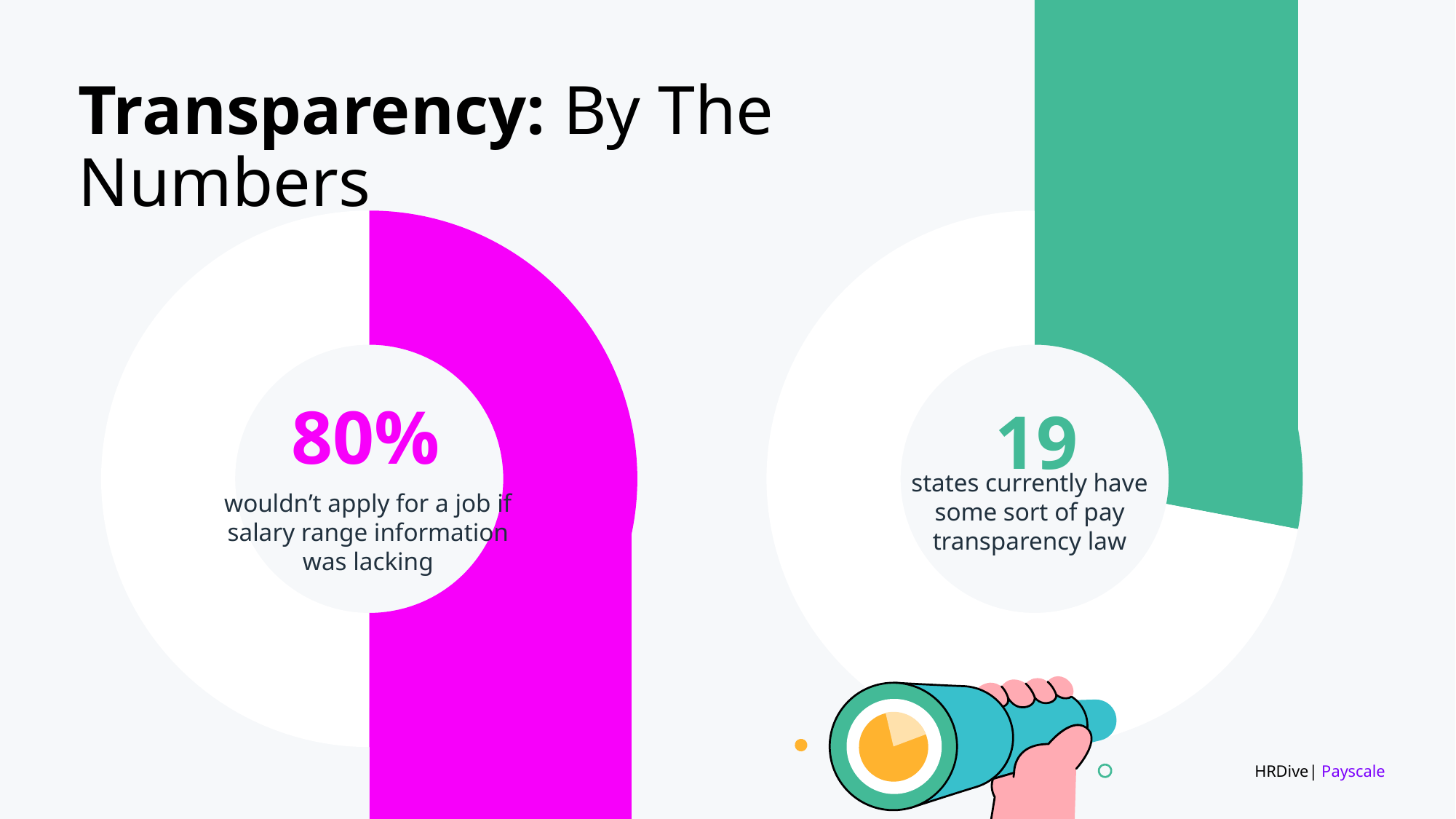
On the left chart, what percentage of people wouldn't apply for a job if salary range information was lacking? 80% What is the title of the slide containing the two charts? Transparency: By The Numbers How many charts are shown on the slide? 2 On the right chart, how many states currently have some sort of pay transparency law? 19 What colour is the highlighted segment of the left chart? magenta What kind of chart is used on the left side of the slide to show the 80% figure? donut chart